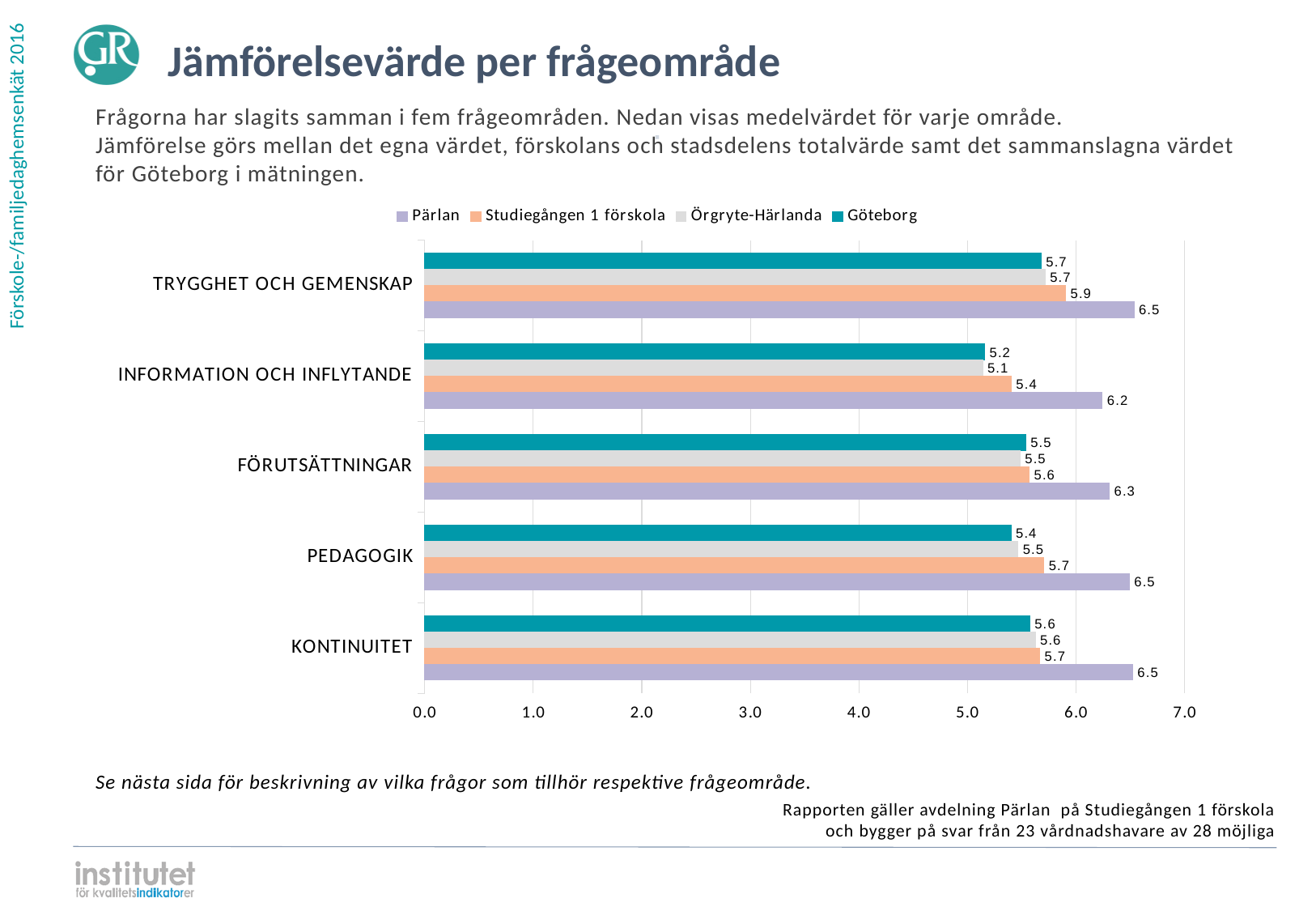
What is the difference between the Pärlan value and the Göteborg value in the INFORMATION OCH INFLYTANDE category? 1.0 What kind of chart is shown on the slide? Bar chart What is the value for Pärlan in the TRYGGHET OCH GEMENSKAP category? 6.5 What is the value for Göteborg in the INFORMATION OCH INFLYTANDE category? 5.2 How many series does the legend list? 4 What is the value for Örgryte-Härlanda in the FÖRUTSÄTTNINGAR category? 5.5 What is the value for Studiegången 1 förskola in the PEDAGOGIK category? 5.7 Is the value for Pärlan in the FÖRUTSÄTTNINGAR category greater or less than 6.0? greater In which category does Pärlan have its lowest value? INFORMATION OCH INFLYTANDE Which is larger in the KONTINUITET category: the value for Pärlan or the value for Studiegången 1 förskola? Pärlan What is the title of the slide containing the chart? Jämförelsevärde per frågeområde How many categories (frågeområden) are shown on the chart? 5